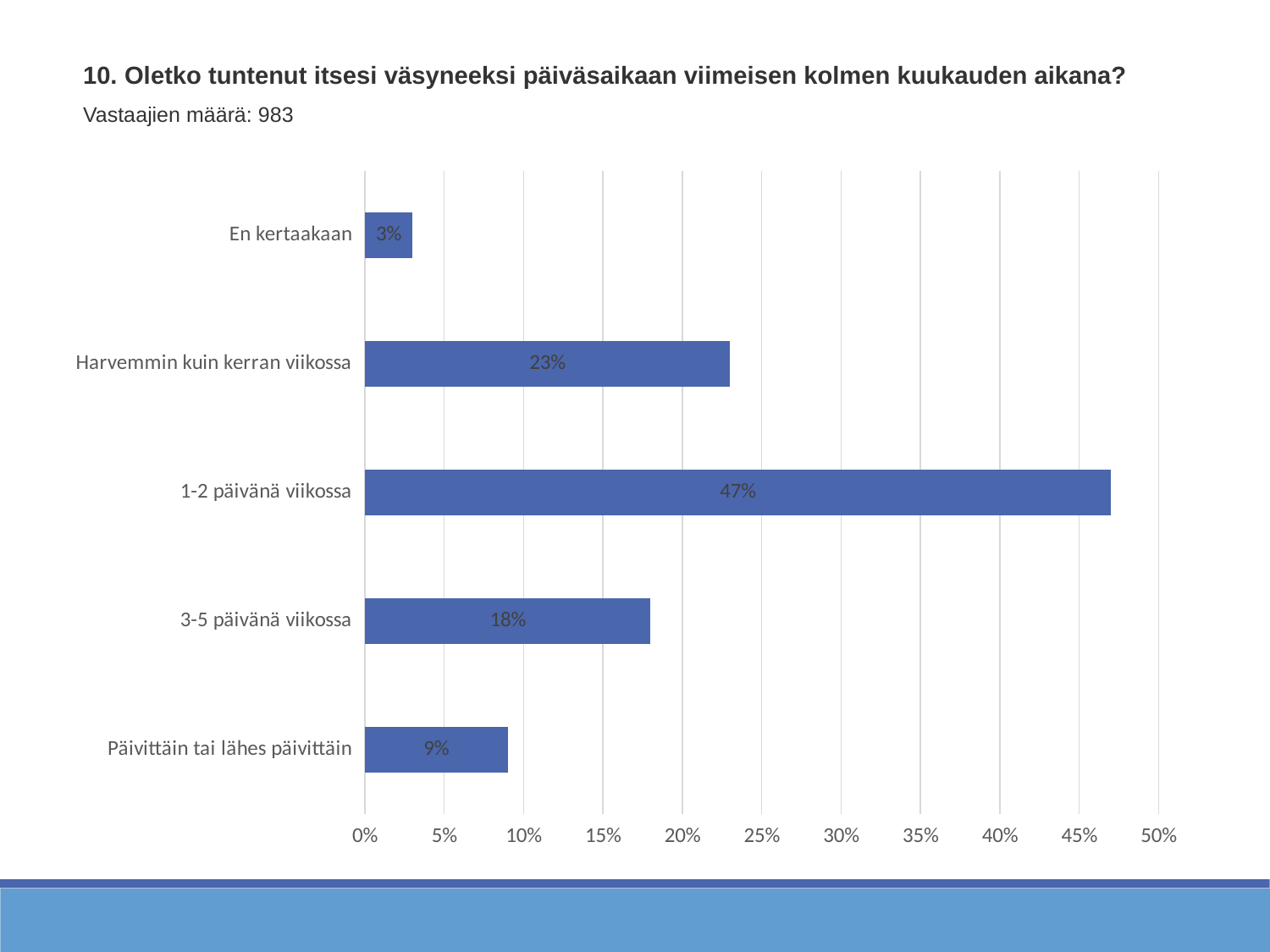
How many categories are shown in the chart? 5 What is the value for "Harvemmin kuin kerran viikossa"? 23% How many respondents (Vastaajien määrä) are reported on the slide? 983 Which is larger, the value for "3-5 päivänä viikossa" or the value for "Päivittäin tai lähes päivittäin"? 3-5 päivänä viikossa Is the value for "3-5 päivänä viikossa" greater or less than 20%? less What is the value for "Päivittäin tai lähes päivittäin"? 9% What is the difference between the values for "1-2 päivänä viikossa" and "Harvemmin kuin kerran viikossa"? 24% What kind of chart is shown on the slide? bar chart Which category has the lowest value? En kertaakaan Which category has the highest value? 1-2 päivänä viikossa What is the value for "En kertaakaan"? 3% What is the value for "1-2 päivänä viikossa"? 47%